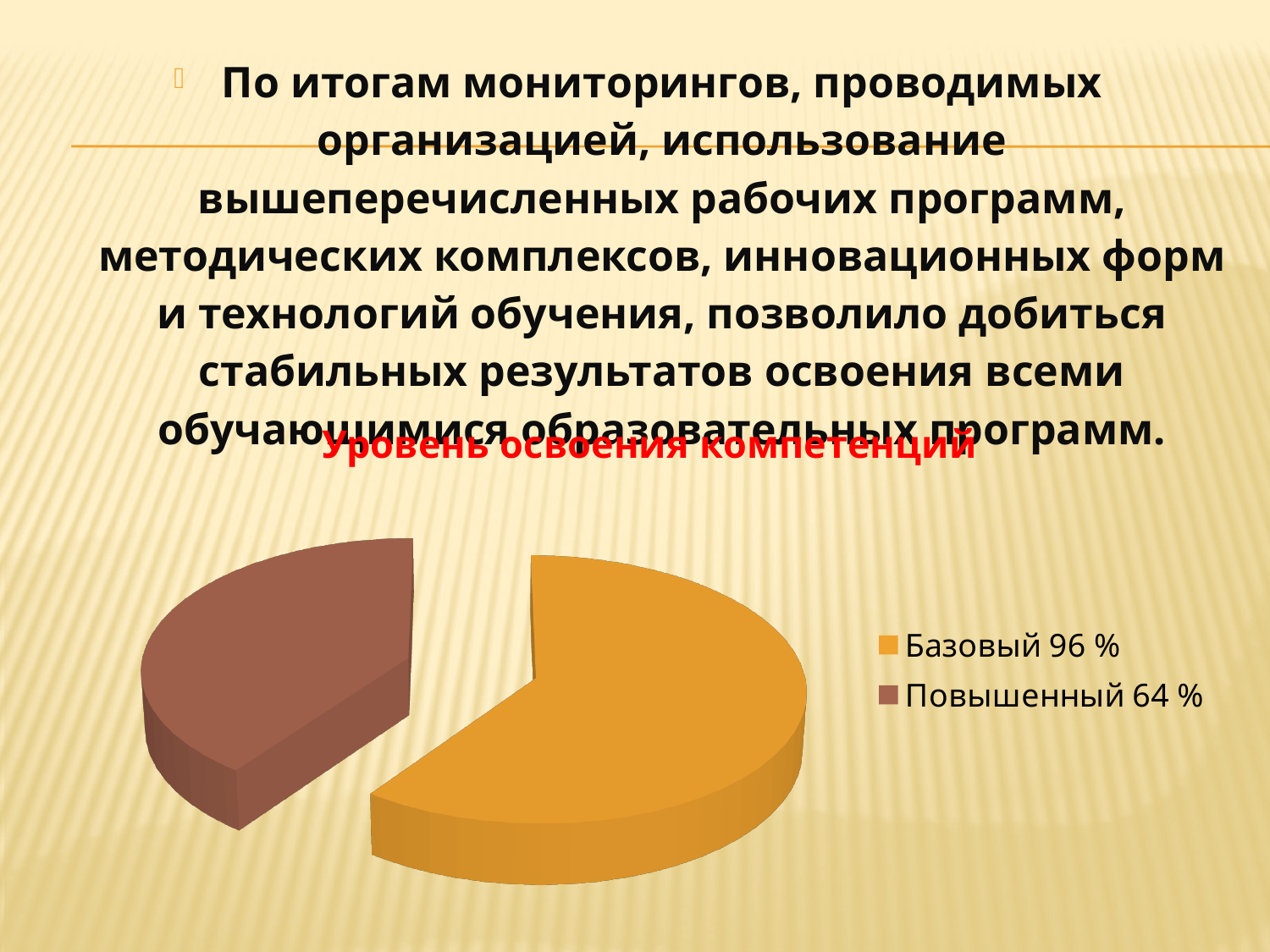
What value is given for Повышенный in the legend? 64 % What colour is the slice for Повышенный? brown What kind of chart is shown on the slide? pie chart How many slices does the pie chart have? 2 What is the title of the chart? Уровень освоения компетенций Which category has the smallest slice of the pie? Повышенный Which is larger, the value for Базовый or the value for Повышенный? Базовый What is the difference between the value for Базовый and the value for Повышенный? 32 % How many entries does the chart legend list? 2 Which category has the largest slice of the pie? Базовый What value is given for Базовый in the legend? 96 %